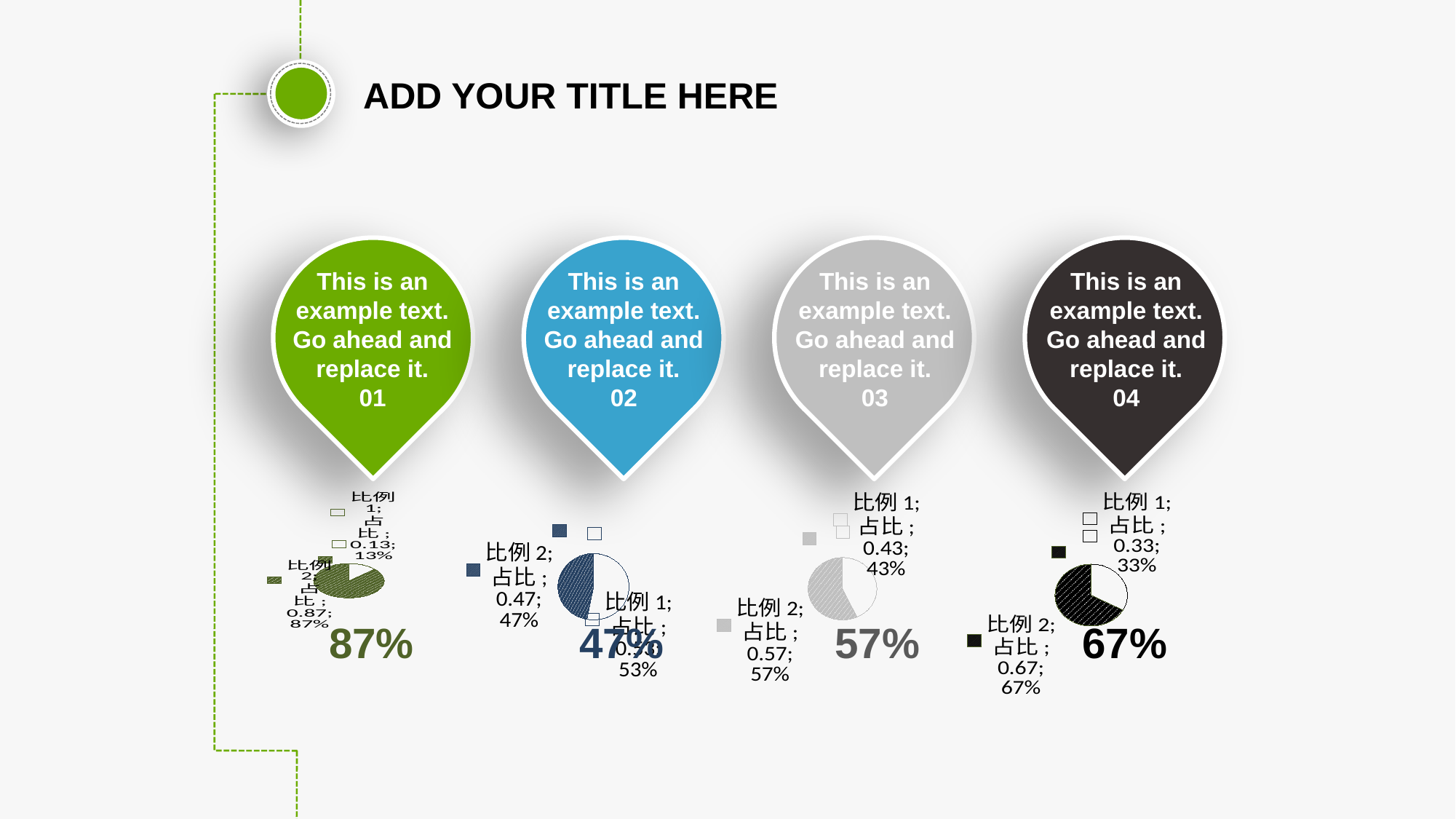
In the leftmost pie chart (under marker 01), which slice is the largest? 比例 2 In the second pie chart (under marker 02), what percentage is shown for 比例 2? 47% In the fourth pie chart (under marker 04), what percentage is shown for 比例 1? 33% How many pie charts are shown on the slide? 4 In the second pie chart (under marker 02), what percentage is shown for 比例 1? 53% How many slices does each pie chart on the slide have? 2 In the leftmost pie chart (under marker 01), what percentage is shown for 比例 1? 13% What kind of chart is shown under each of the four numbered markers? Pie chart In the leftmost pie chart (under marker 01), what percentage is shown for 比例 2? 87% In the third pie chart (under marker 03), what is the difference between the 比例 2 and 比例 1 percentages? 14% In the fourth pie chart (under marker 04), which slice is larger, 比例 1 or 比例 2? 比例 2 In the third pie chart (under marker 03), what percentage is shown for 比例 2? 57%